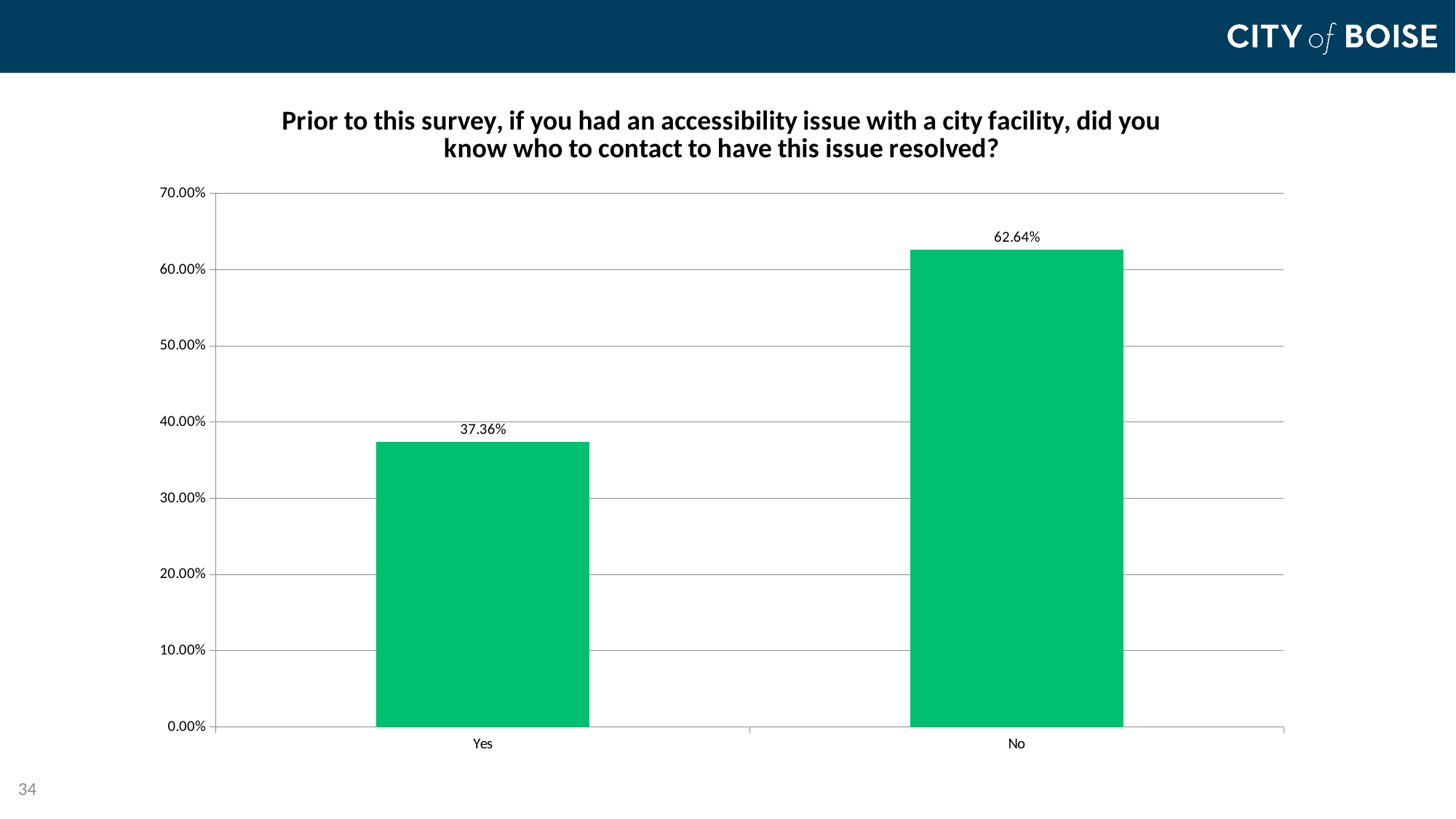
What percentage of respondents answered "Yes"? 37.36% What is the total of the "Yes" and "No" percentages? 100.00% What kind of chart is shown on the slide? bar chart Is the value for "Yes" greater or less than 40.00%? less Is the value for "No" greater or less than 60.00%? greater What is the highest value shown on the y axis? 70.00% Which is larger, the value for "Yes" or the value for "No"? No What percentage of respondents answered "No"? 62.64% How many response categories are shown on the x axis? 2 Which response category has the lowest value? Yes What is the difference between the "No" and "Yes" percentages? 25.28% Which response category has the highest value? No